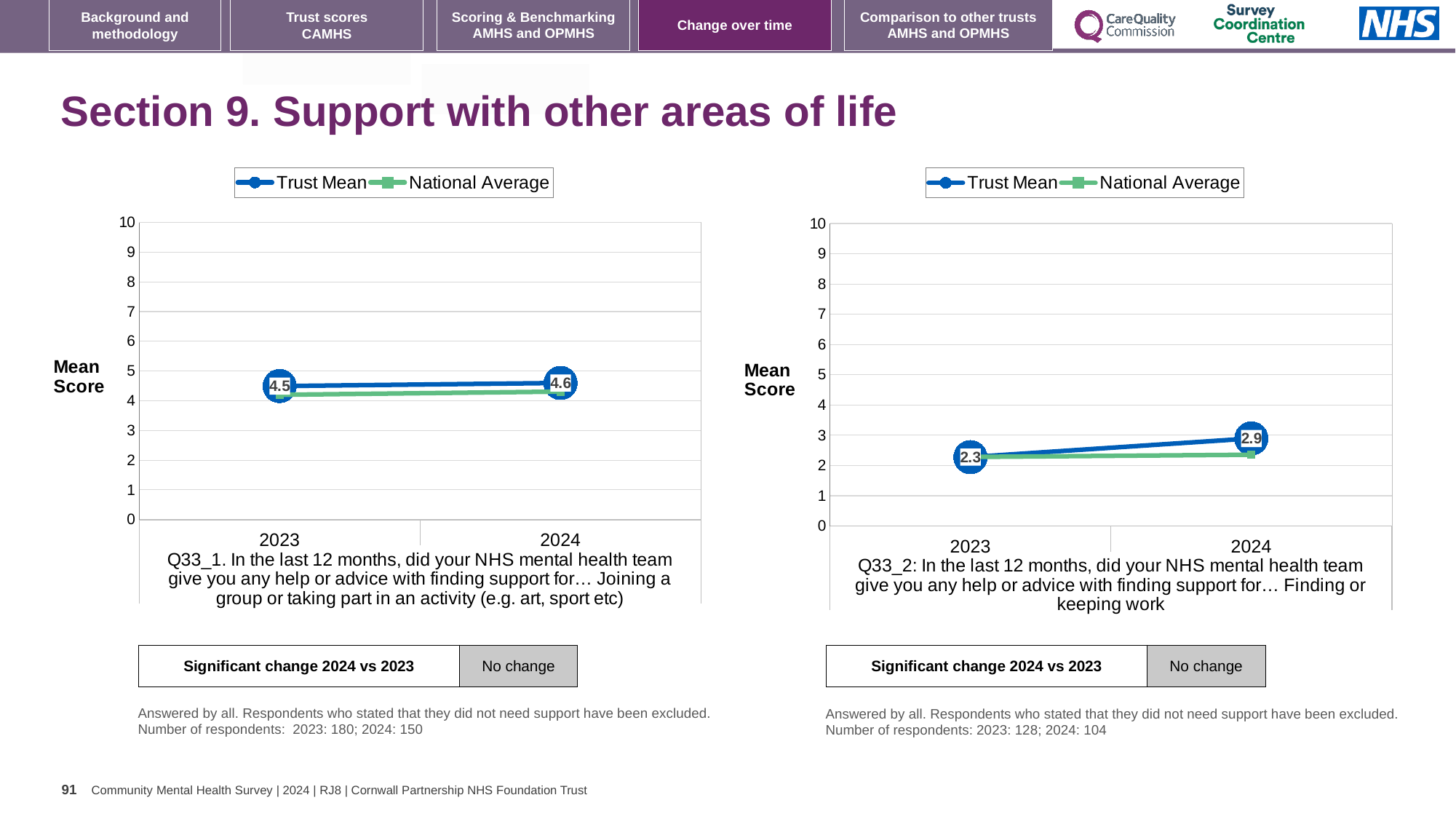
How many years are plotted on the x axis of the right chart (Q33_2)? 2 What kind of chart is the left chart (Q33_1)? line chart On the right chart (Q33_2), what is the Trust Mean score for 2024? 2.9 On the right chart (Q33_2), what is the Trust Mean score for 2023? 2.3 On the left chart (Q33_1), is the National Average for 2024 greater or less than 5? less On the right chart (Q33_2), which year has the higher Trust Mean, 2023 or 2024? 2024 On the right chart (Q33_2), by how much did the Trust Mean change from 2023 to 2024? 0.6 On the left chart (Q33_1), what is the Trust Mean score for 2023? 4.5 On the left chart (Q33_1), what is the difference between the Trust Mean for 2024 and 2023? 0.1 On the left chart (Q33_1), what is the Trust Mean score for 2024? 4.6 How many series does the legend of the left chart list? 2 On the right chart (Q33_2), does the Trust Mean rise or fall from 2023 to 2024? rise